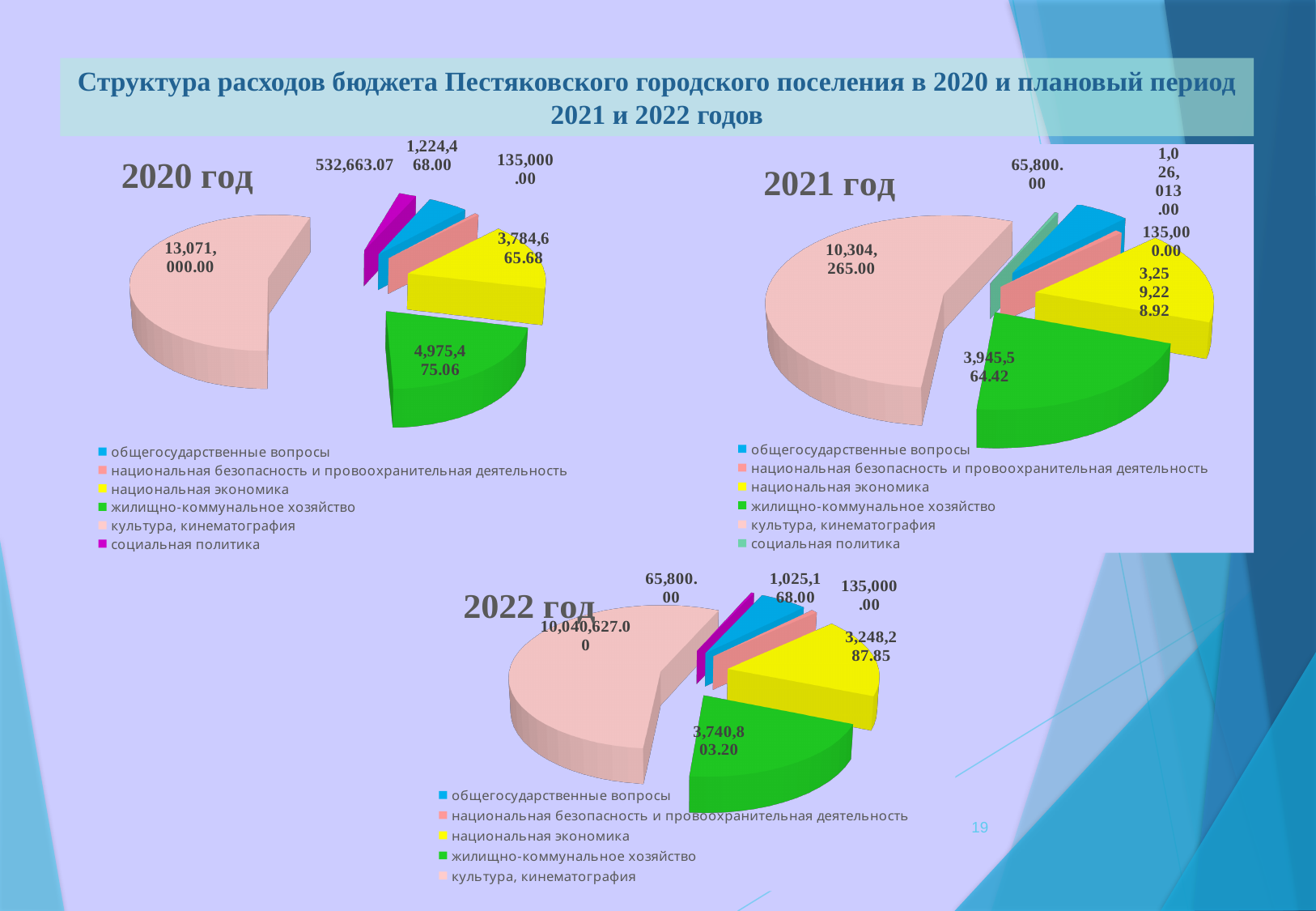
In the 2020 год chart, what is the difference between жилищно-коммунальное хозяйство and национальная экономика? 1,190,809.38 In the 2022 год chart, what is the value for общегосударственные вопросы? 1,025,168.00 In the 2021 год chart, what is the value for национальная экономика? 3,259,228.92 How many entries does the legend of the 2022 год chart list? 5 In the 2020 год chart, what is the value for жилищно-коммунальное хозяйство? 4,975,475.06 In the 2020 год chart, which is larger: общегосударственные вопросы or социальная политика? общегосударственные вопросы What kind of chart is used for the 2020 год chart? pie chart In the 2020 год chart, what is the value for культура, кинематография? 13,071,000.00 In the 2021 год chart, what is the value for социальная политика? 65,800.00 In the 2021 год chart, what is the difference between жилищно-коммунальное хозяйство and национальная экономика? 686,335.50 In the 2021 год chart, which category has the largest value? культура, кинематография In the 2020 год chart, which category has the smallest value? национальная безопасность и провоохранительная деятельность